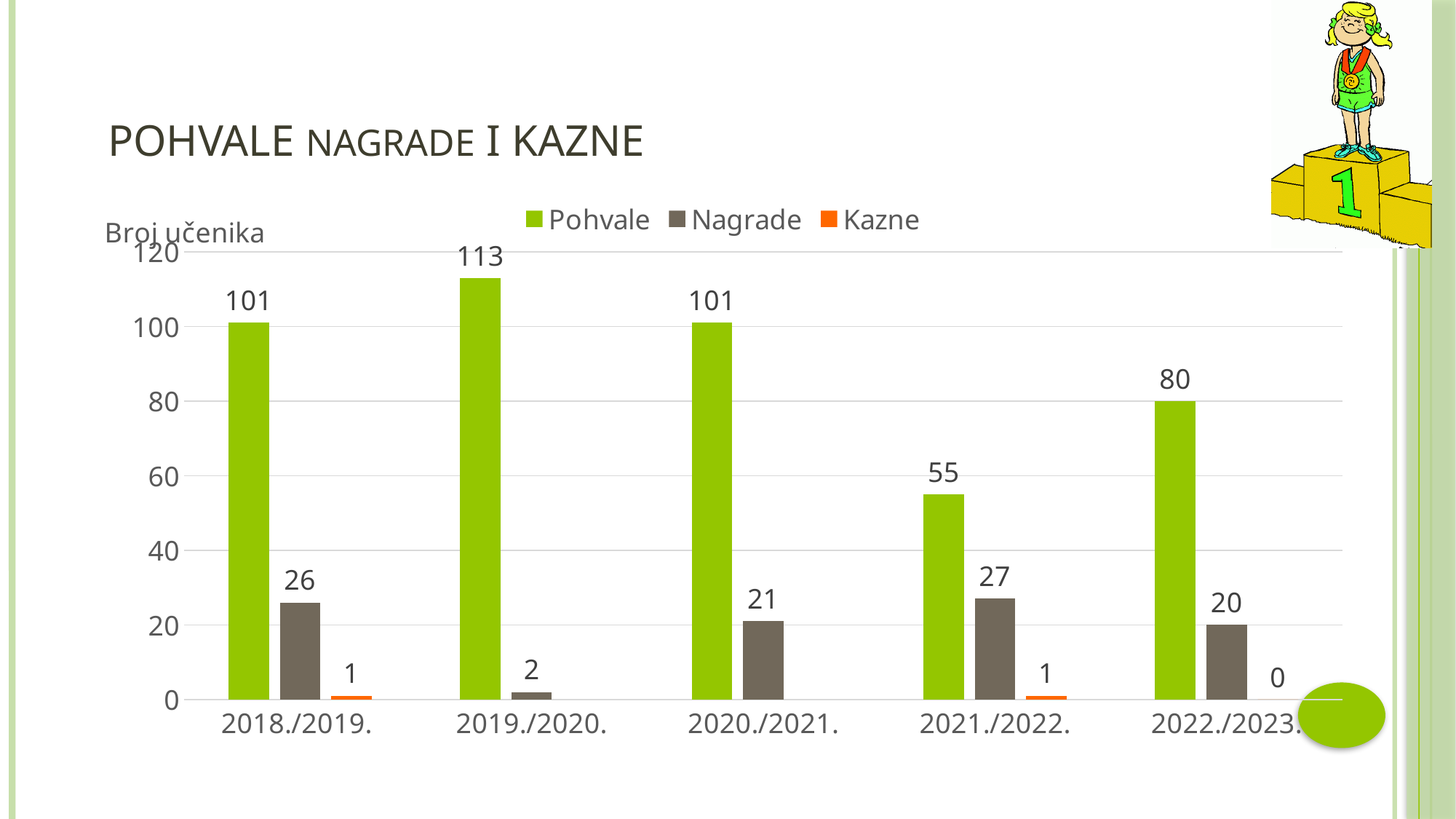
In which school year is the Pohvale value highest? 2019./2020. What is the label on the vertical axis of the chart? Broj učenika Is the value of Pohvale for 2022./2023. greater or less than 100? less What is the value of Pohvale for 2019./2020.? 113 Which is larger: Nagrade in 2018./2019. or Nagrade in 2020./2021.? Nagrade in 2018./2019. In which school year is the Pohvale value lowest? 2021./2022. What is the value of Nagrade for 2021./2022.? 27 What is the difference between Pohvale in 2019./2020. and Pohvale in 2022./2023.? 33 How many school years are shown on the x axis? 5 What is the value of Kazne for 2022./2023.? 0 What type of chart is shown on the slide? bar chart How many series does the legend list? 3